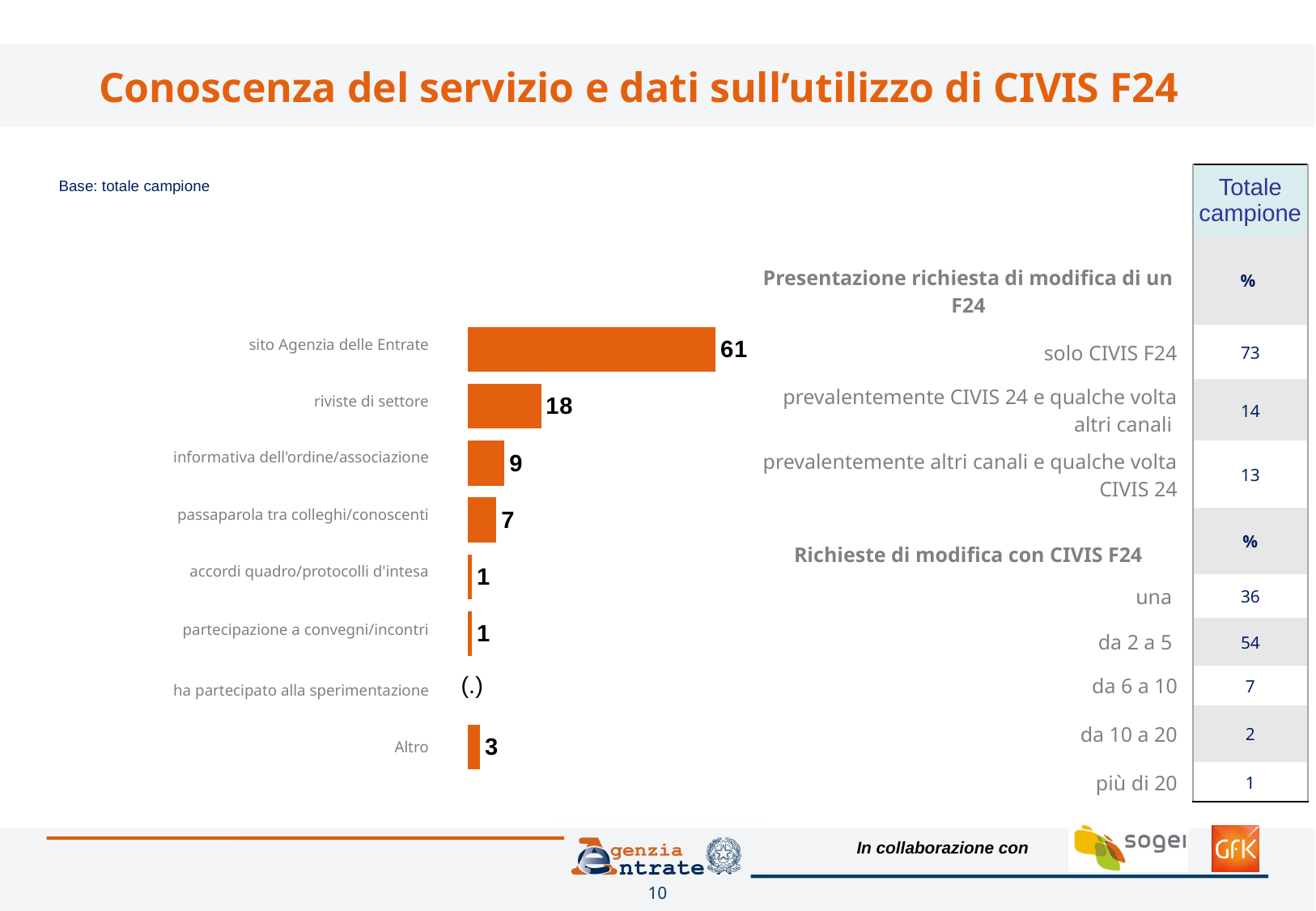
What is the value for "sito Agenzia delle Entrate" in the bar chart? 61 What colour are the bars in the bar chart? orange What is the value for "Altro" in the bar chart? 3 What kind of chart is shown on the left of the slide? bar chart What is the value for "informativa dell'ordine/associazione" in the bar chart? 9 Which is larger in the bar chart: "informativa dell'ordine/associazione" or "passaparola tra colleghi/conoscenti"? informativa dell'ordine/associazione How many categories are shown in the bar chart? 8 What is the value for "accordi quadro/protocolli d'intesa" in the bar chart? 1 Which category has the highest value in the bar chart? sito Agenzia delle Entrate What is the value for "passaparola tra colleghi/conoscenti" in the bar chart? 7 What is the difference between the values for "sito Agenzia delle Entrate" and "riviste di settore" in the bar chart? 43 What is the value for "riviste di settore" in the bar chart? 18